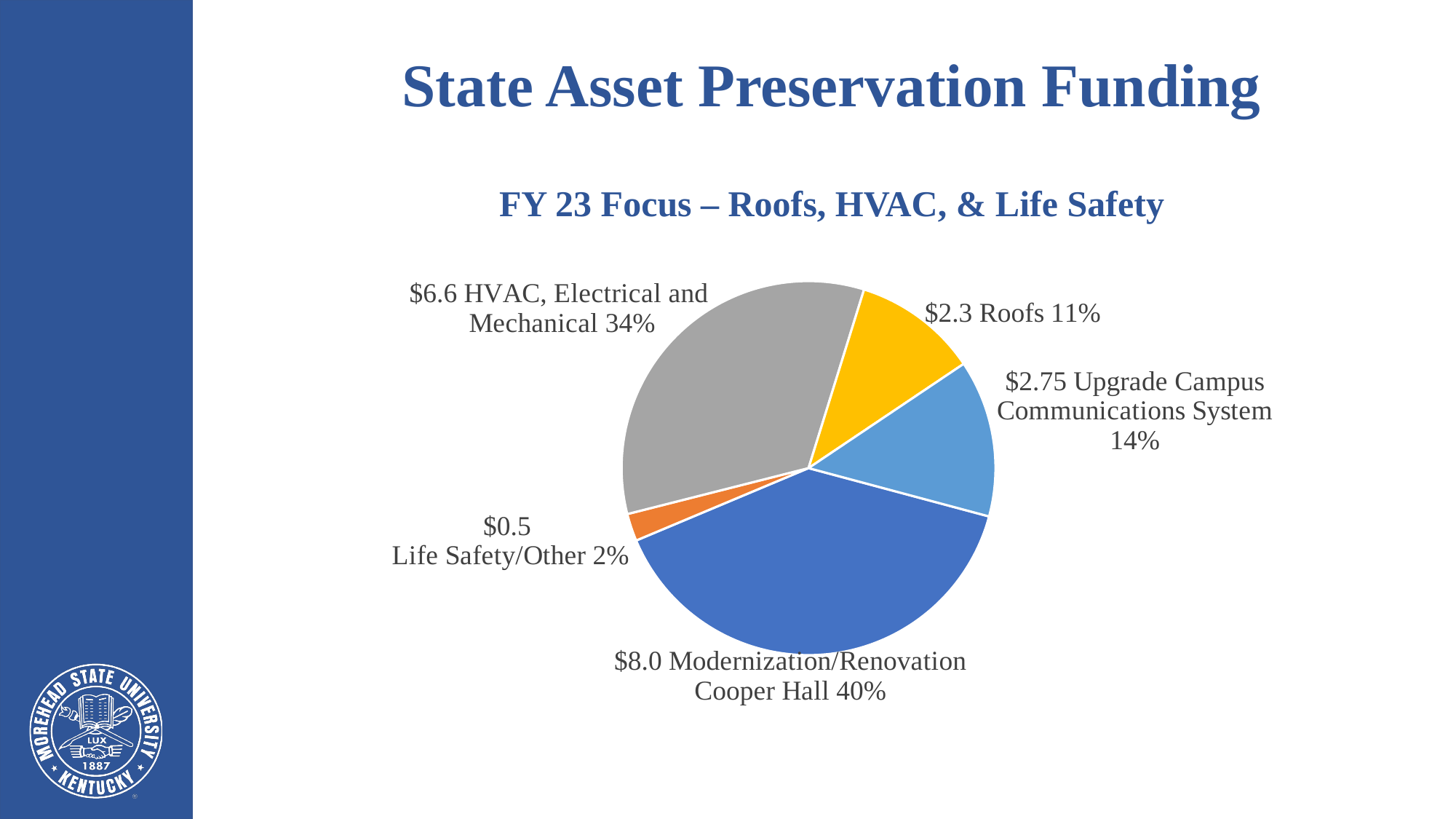
What percentage share does the Modernization/Renovation Cooper Hall slice have? 40% Which is larger, the value for Roofs or the value for Upgrade Campus Communications System? Upgrade Campus Communications System What percentage share does the Upgrade Campus Communications System slice have? 14% What is the dollar value shown for HVAC, Electrical and Mechanical? $6.6 What kind of chart is shown on the slide? Pie chart What is the dollar value shown for Roofs? $2.3 Which category has the largest slice of the pie? Modernization/Renovation Cooper Hall What is the subtitle shown above the pie chart? FY 23 Focus – Roofs, HVAC, & Life Safety How many slices does the pie chart have? 5 What is the dollar value shown for Life Safety/Other? $0.5 What is the difference between the dollar value for Modernization/Renovation Cooper Hall and the dollar value for HVAC, Electrical and Mechanical? $1.4 Which category has the smallest slice of the pie? Life Safety/Other